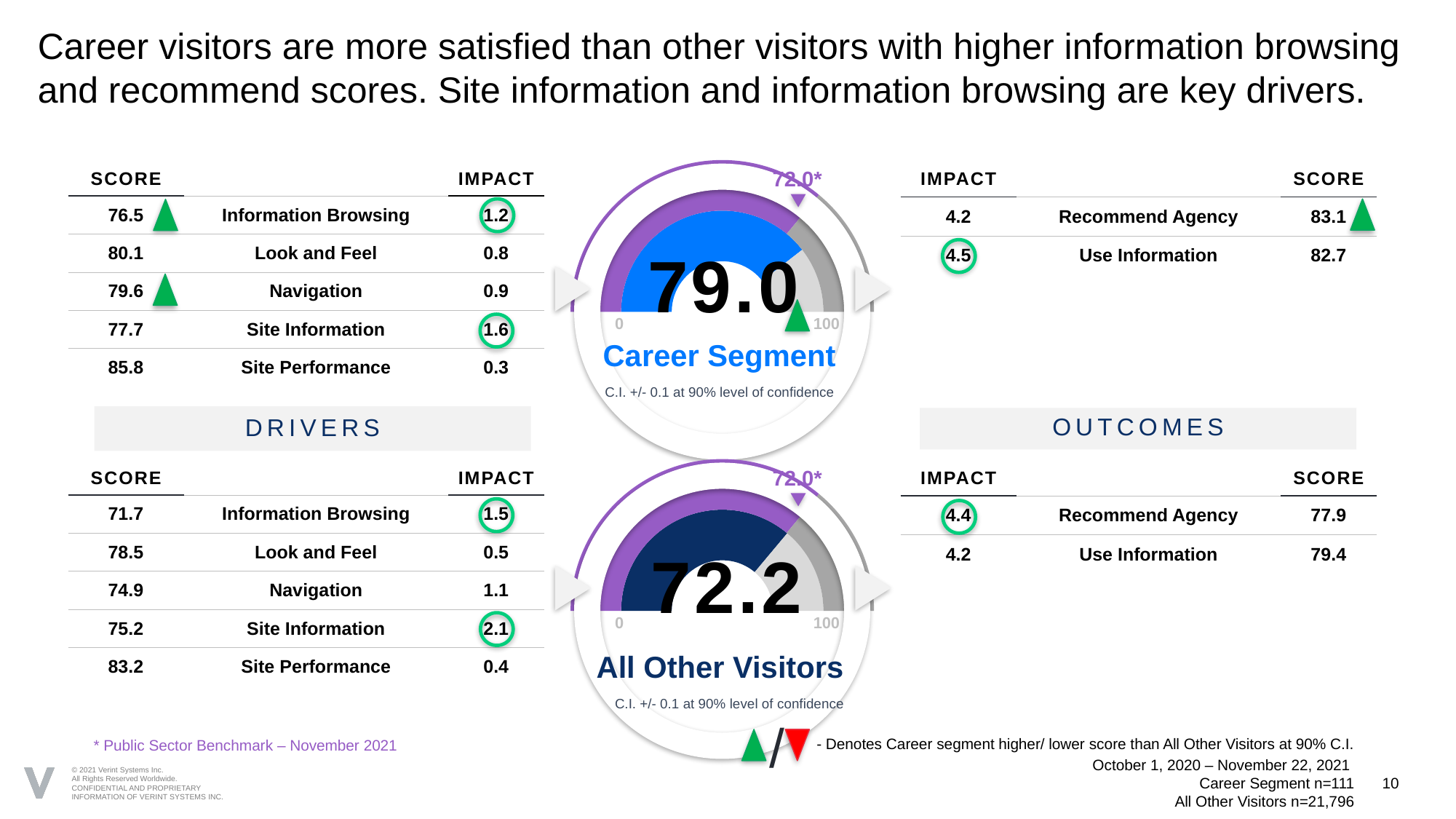
What confidence interval is stated beneath the Career Segment gauge? C.I. +/- 0.1 at 90% level of confidence In the Career Segment drivers table, what is the score for Site Performance? 85.8 What is the Public Sector Benchmark value marked on the gauges? 72.0* What is the difference between the Career Segment gauge value and the All Other Visitors gauge value? 6.8 What kind of chart is used to display the Career Segment score? gauge chart What is the value shown on the All Other Visitors gauge? 72.2 Is the Career Segment gauge value greater or less than the 72.0 benchmark? greater What are the minimum and maximum values on the gauge scales? 0 and 100 In the All Other Visitors drivers table, which driver has the highest impact? Site Information What is the value shown on the Career Segment gauge? 79.0 Which gauge shows the higher score, Career Segment or All Other Visitors? Career Segment How many gauge charts are shown on the slide? 2